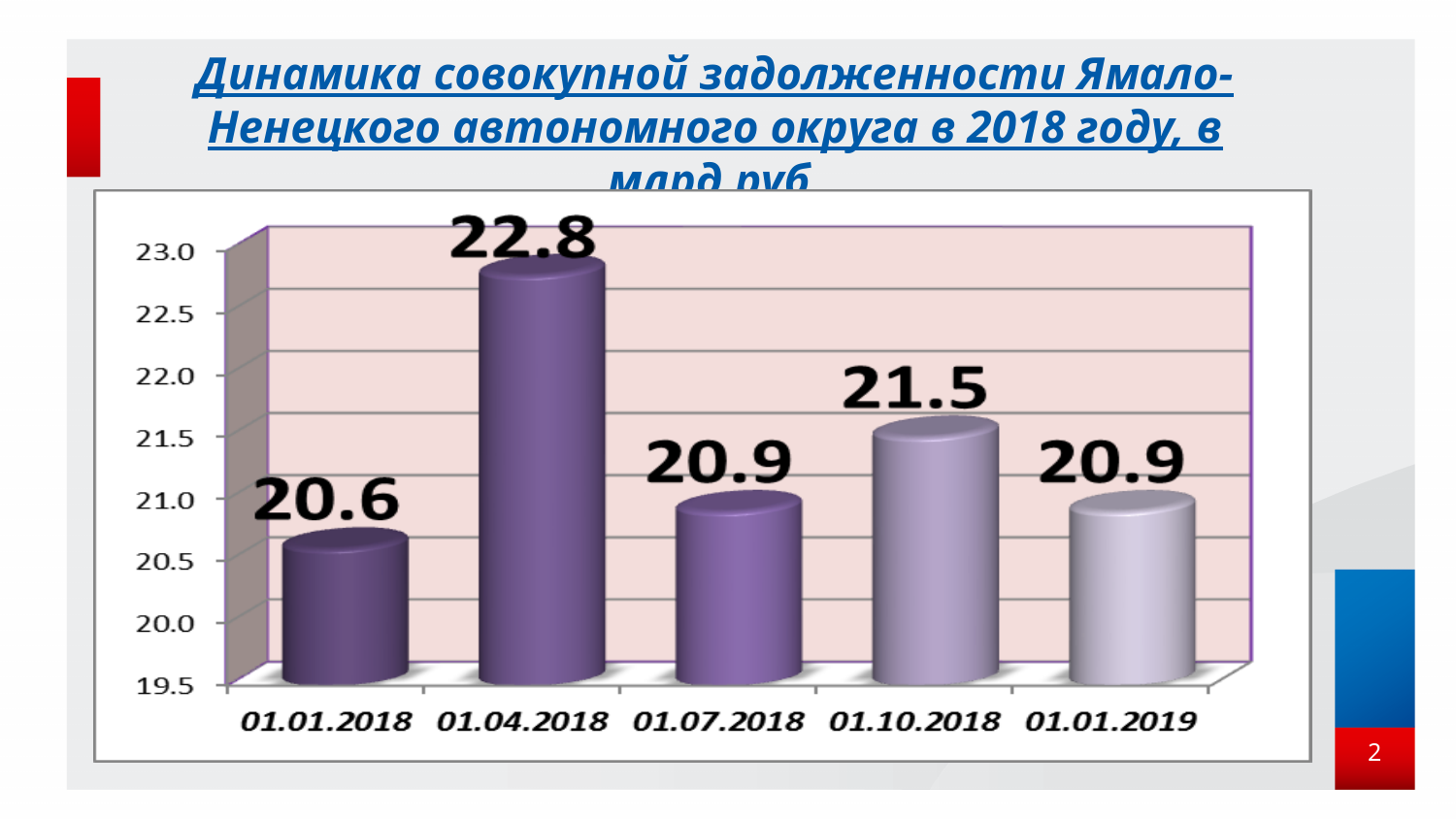
What is the value for 01.01.2018? 20.6 Does the value rise or fall from 01.04.2018 to 01.07.2018? fall What is the difference between the values for 01.04.2018 and 01.01.2018? 2.2 What is the difference between the values for 01.10.2018 and 01.07.2018? 0.6 What kind of chart is shown on the slide? bar chart Which is larger, the value for 01.10.2018 or the value for 01.01.2019? 01.10.2018 What is the value for 01.01.2019? 20.9 What is the value for 01.04.2018? 22.8 Which date has the highest value? 01.04.2018 What is the value for 01.10.2018? 21.5 Which date has the lowest value? 01.01.2018 How many dates are shown on the x axis? 5